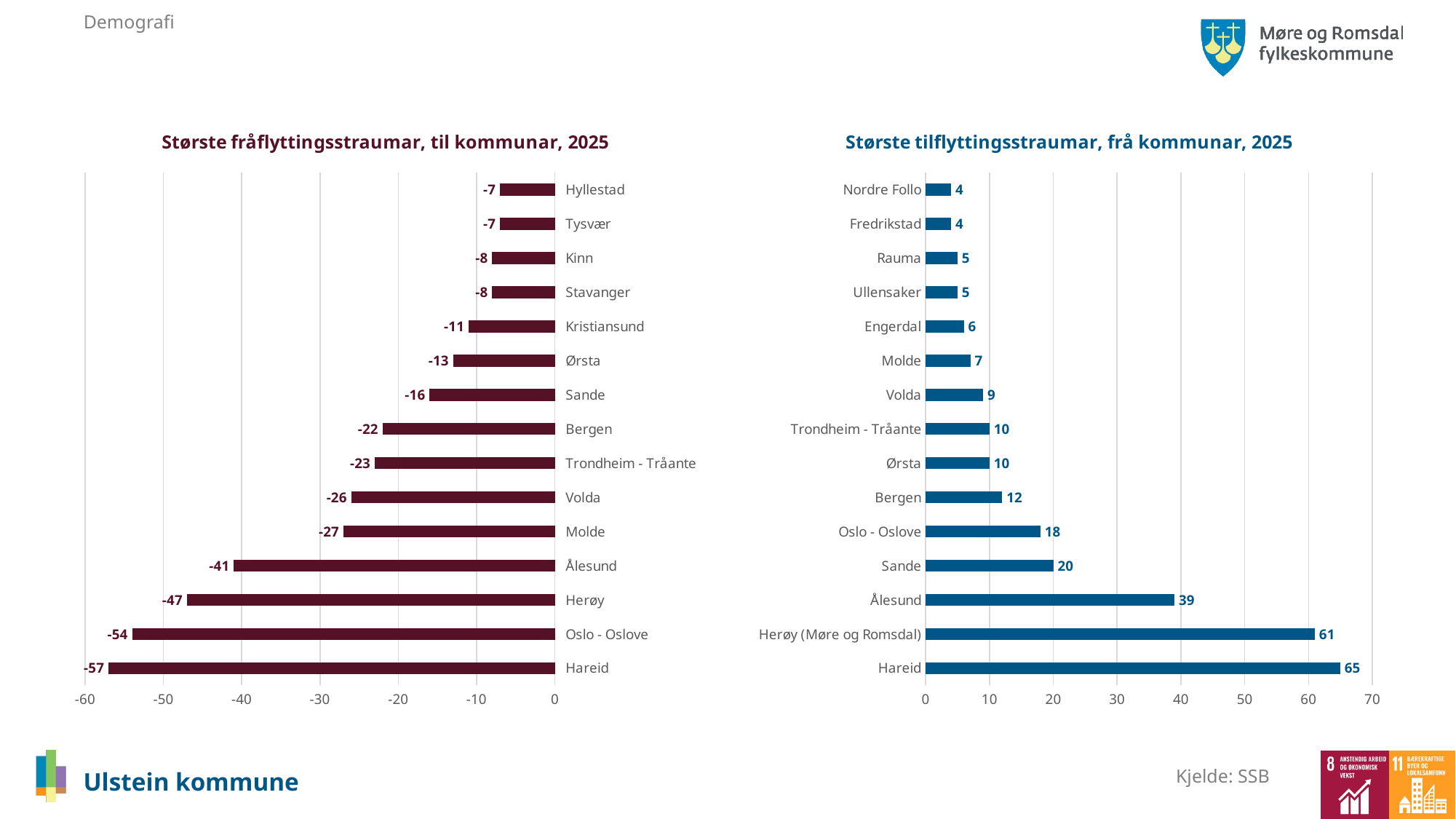
In the chart 'Største tilflyttingsstraumar, frå kommunar, 2025', what is the value for Sande? 20 In the chart 'Største fråflyttingsstraumar, til kommunar, 2025', what is the value for Ålesund? -41 In the chart 'Største fråflyttingsstraumar, til kommunar, 2025', what is the difference between the values for Oslo - Oslove and Herøy? 7 In the chart 'Største tilflyttingsstraumar, frå kommunar, 2025', which is larger, the value for Ålesund or the value for Oslo - Oslove? Ålesund In the chart 'Største tilflyttingsstraumar, frå kommunar, 2025', which category has the highest value? Hareid In the chart 'Største fråflyttingsstraumar, til kommunar, 2025', what is the value for Kristiansund? -11 What kind of chart is 'Største tilflyttingsstraumar, frå kommunar, 2025'? Bar chart How many categories are shown in the chart 'Største tilflyttingsstraumar, frå kommunar, 2025'? 15 In the chart 'Største fråflyttingsstraumar, til kommunar, 2025', which category has the lowest (most negative) value? Hareid In the chart 'Største tilflyttingsstraumar, frå kommunar, 2025', what is the difference between the values for Hareid and Herøy (Møre og Romsdal)? 4 What source is cited at the bottom of the slide? SSB How many categories are shown in the chart 'Største fråflyttingsstraumar, til kommunar, 2025'? 15